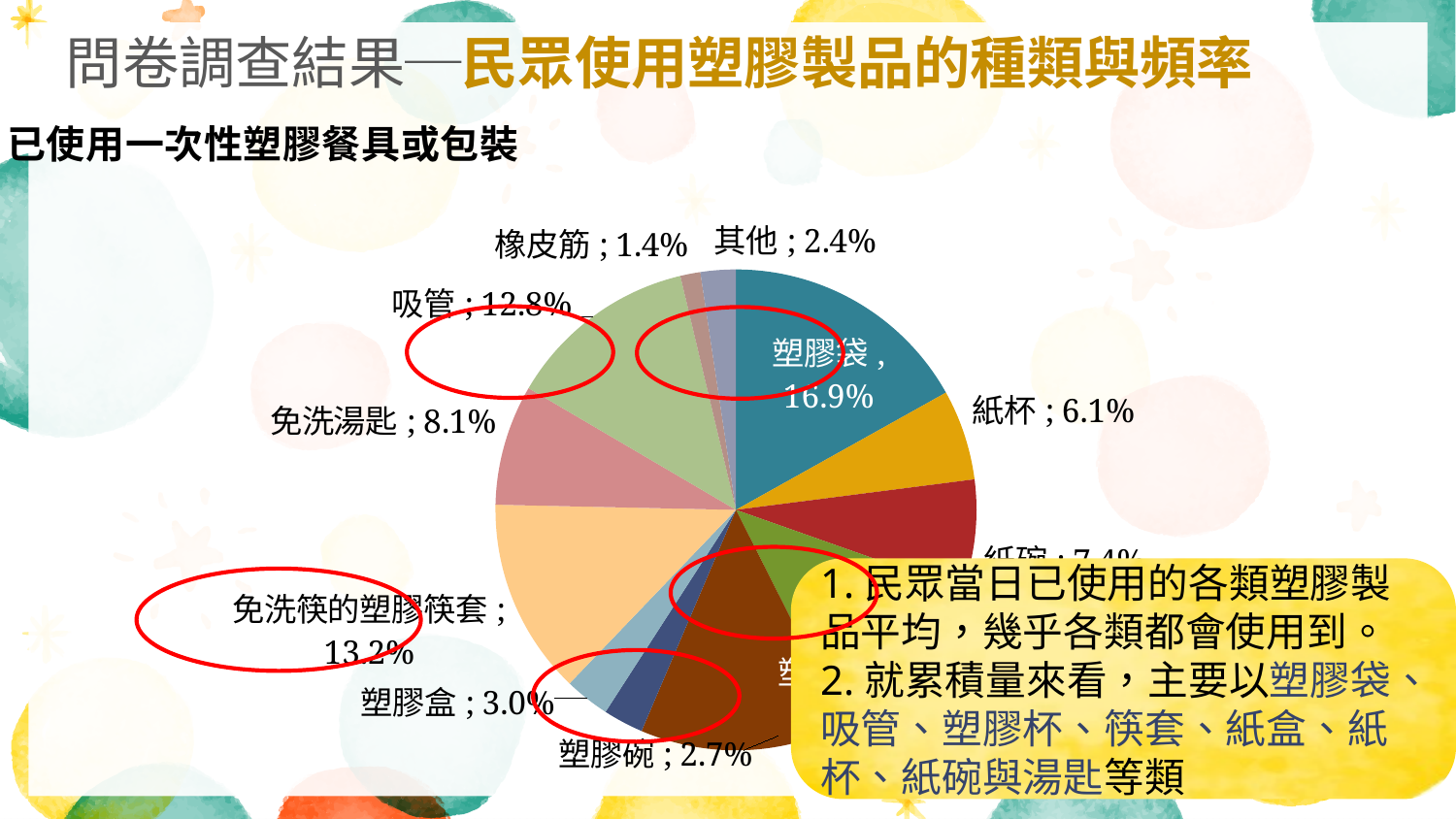
Which category has the smallest slice in the pie chart? 橡皮筋 What is the share for 其他 in the pie chart? 2.4% Which has a larger share, 吸管 or 免洗筷的塑膠筷套? 免洗筷的塑膠筷套 What is the difference in share between 塑膠袋 and 吸管? 4.1% What is the share for 塑膠碗 in the pie chart? 2.7% What is the share for 免洗筷的塑膠筷套 in the pie chart? 13.2% What is the share for 紙杯 in the pie chart? 6.1% What is the share for 橡皮筋 in the pie chart? 1.4% What is the share for 吸管 in the pie chart? 12.8% What is the difference in share between 免洗湯匙 and 紙杯? 2.0% What is the share for 塑膠袋 in the pie chart? 16.9% What type of chart is shown on the slide? pie chart